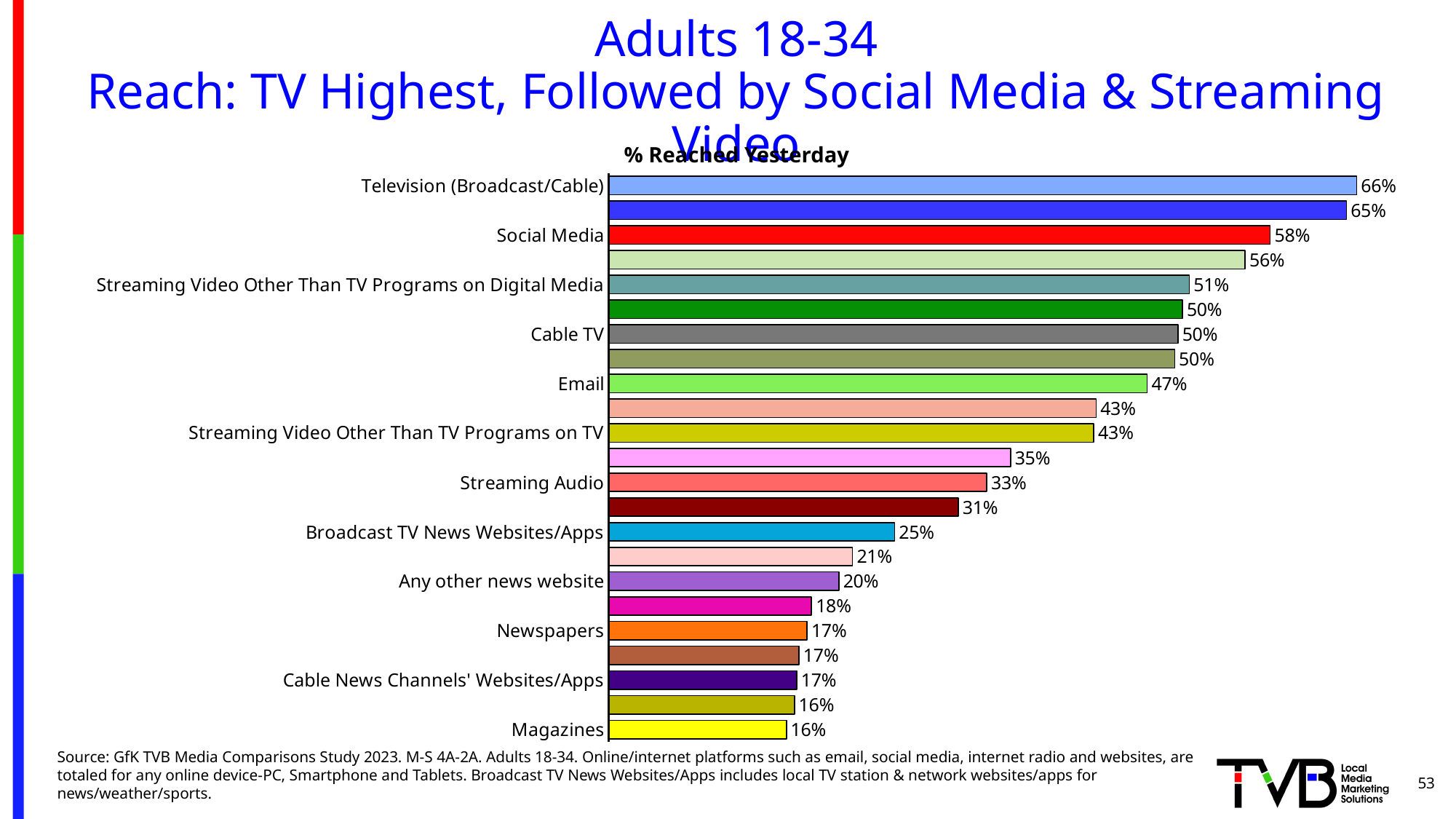
What is the difference between Television (Broadcast/Cable) and Social Media? 8% What is the value for Broadcast TV News Websites/Apps? 25% What is the value for Email? 47% What is the title of the chart? % Reached Yesterday What is the value for Streaming Audio? 33% Which is larger, Cable TV or Email? Cable TV What kind of chart is shown? bar chart What is the value for Magazines? 16% Do the bar values increase or decrease from top to bottom? decrease What is the value for Television (Broadcast/Cable)? 66% What is the value for Social Media? 58% Which category has the highest value? Television (Broadcast/Cable)